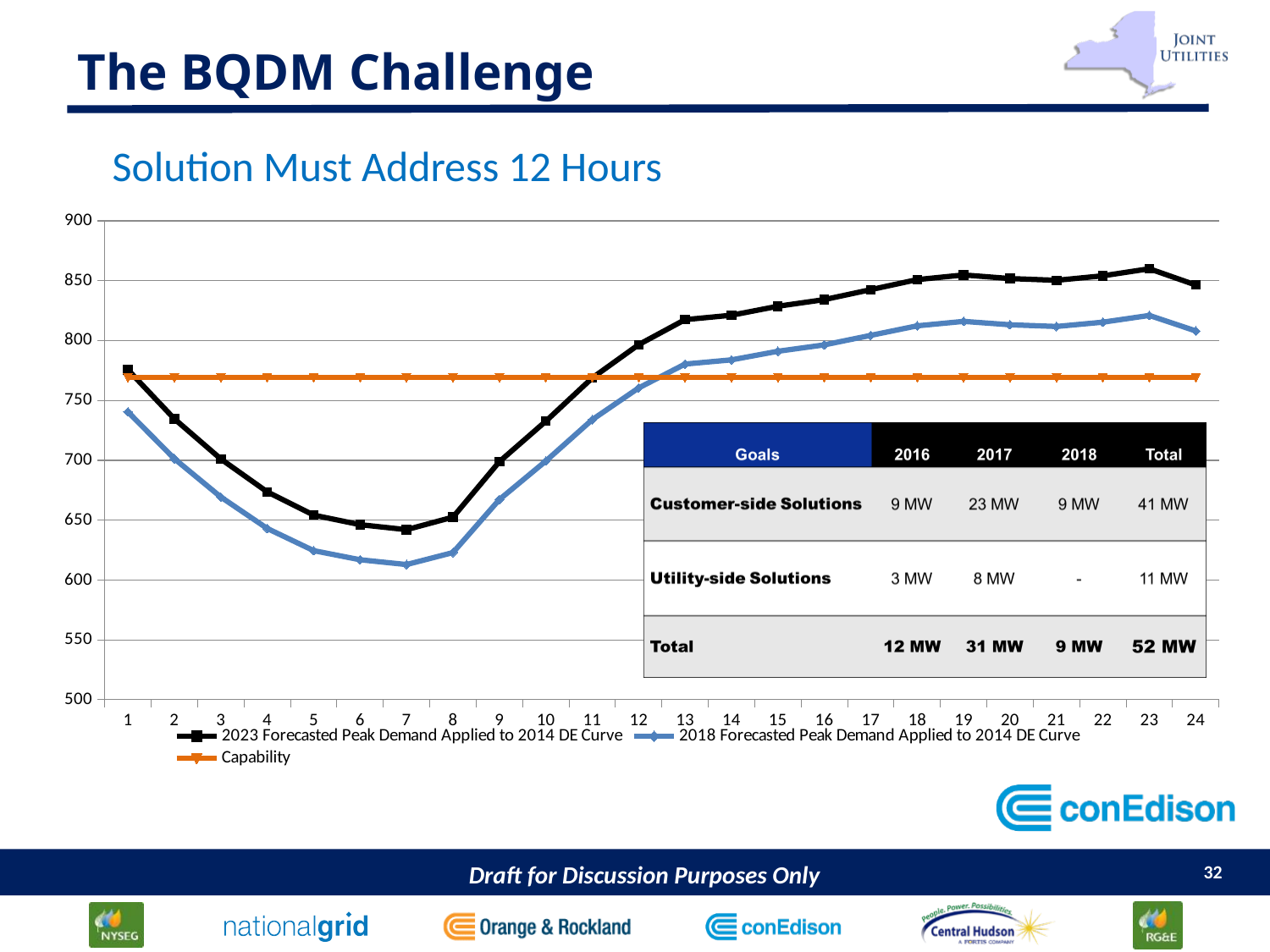
Is the Capability line greater or less than 800? less How many series does the chart legend list? 3 Is the value of the 2018 Forecasted Peak Demand series at hour 7 greater or less than 650? less Does the 2023 Forecasted Peak Demand series rise or fall from hour 1 to hour 7? fall At which hour does the 2023 Forecasted Peak Demand series reach its lowest value? 7 What kind of chart is shown on the slide? line chart How many hours (points) are plotted along the x axis of the chart? 24 At hour 13, which series has the larger value: 2023 Forecasted Peak Demand or 2018 Forecasted Peak Demand? 2023 Forecasted Peak Demand What colour is the Capability line in the chart? orange At which hour does the 2023 Forecasted Peak Demand series reach its highest value? 23 Is the value of the 2023 Forecasted Peak Demand series at hour 19 greater or less than 800? greater At which hour does the 2018 Forecasted Peak Demand series reach its lowest value? 7